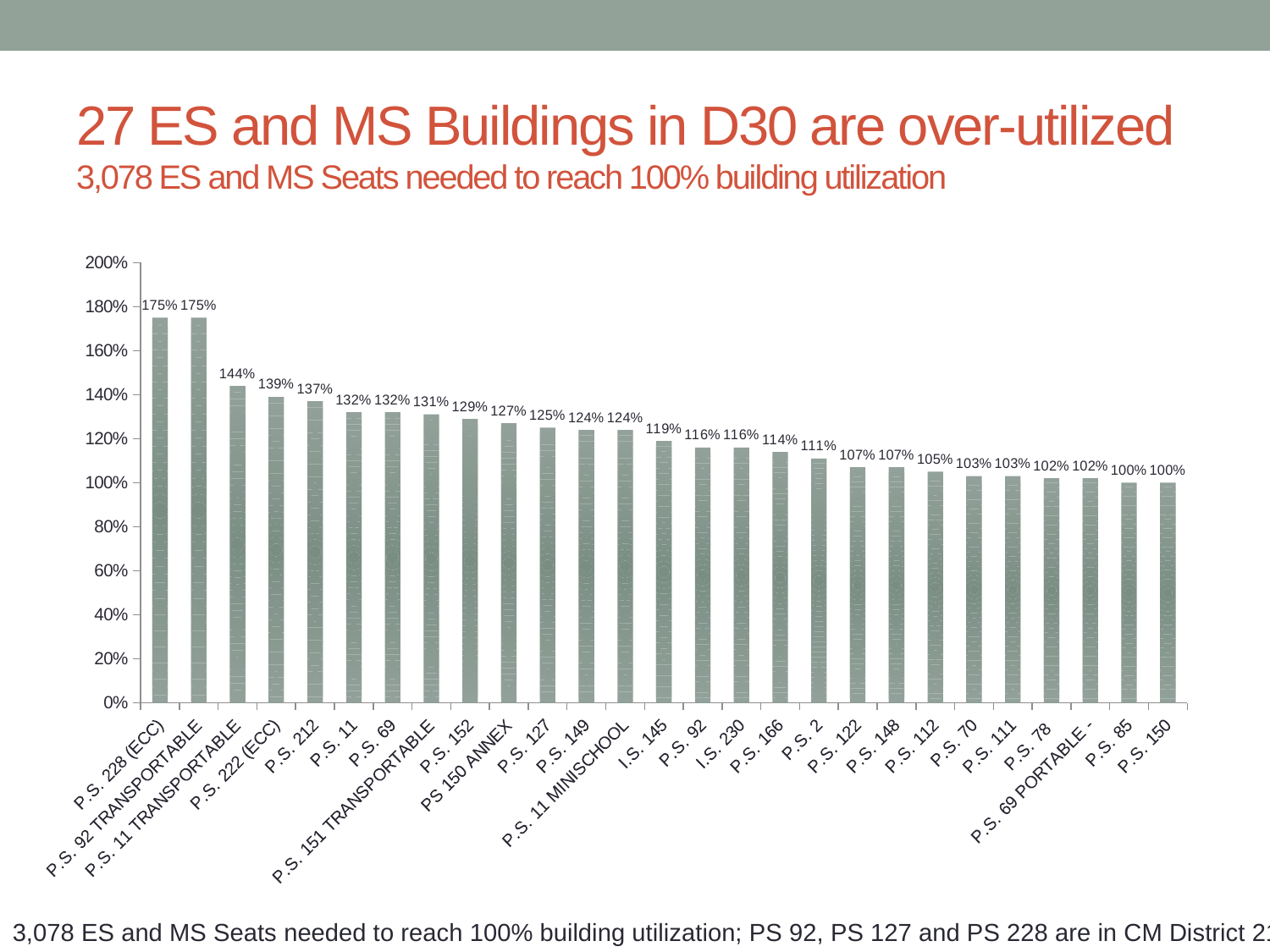
What is the utilization value shown for I.S. 145? 119% What is the difference in percentage points between the values for P.S. 222 (ECC) and P.S. 2? 28 percentage points What is the lowest utilization value shown on the chart? 100% What is the utilization value shown for P.S. 11 TRANSPORTABLE? 144% Do the values rise or fall moving from left to right along the x axis? Fall What is the utilization value shown for P.S. 212? 137% What kind of chart is shown on the slide? Bar chart What is the utilization value shown for P.S. 112? 105% What is the utilization value shown for P.S. 166? 114% What is the highest utilization value shown on the chart? 175% How many buildings (bars) are shown on the chart? 27 Which has the higher utilization value, P.S. 152 or P.S. 127? P.S. 152